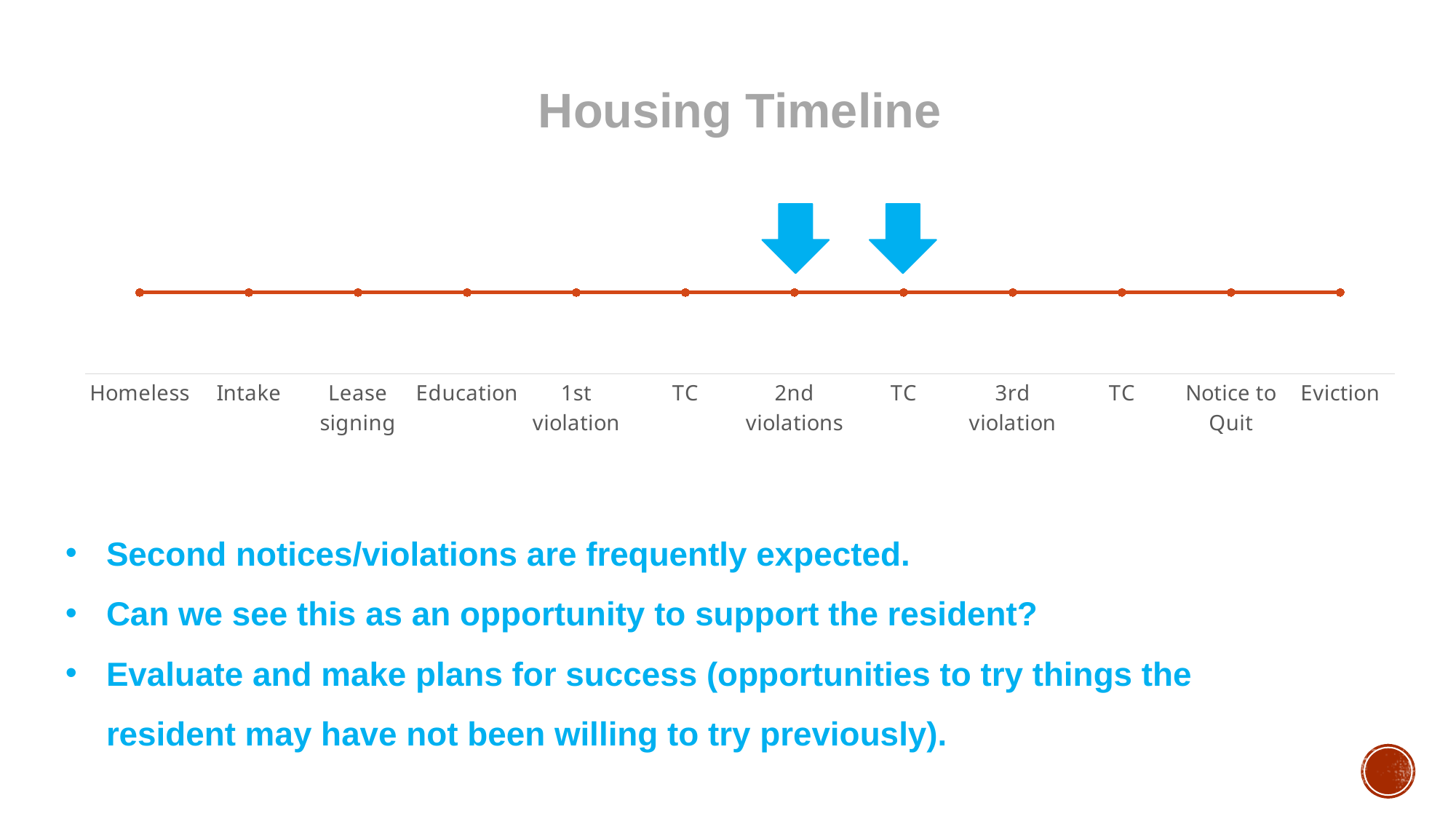
What is the first category on the x axis of the Housing Timeline chart? Homeless What is the last category on the x axis of the Housing Timeline chart? Eviction How many categories are labelled on the x axis of the Housing Timeline chart? 12 Which category on the Housing Timeline comes immediately before "Eviction"? Notice to Quit What kind of chart is used to show the Housing Timeline? line chart How many times does the label "TC" appear on the x axis of the Housing Timeline chart? 3 Do the plotted values on the Housing Timeline rise, fall, or stay flat along the x axis? stay flat How many points are plotted along the Housing Timeline line? 12